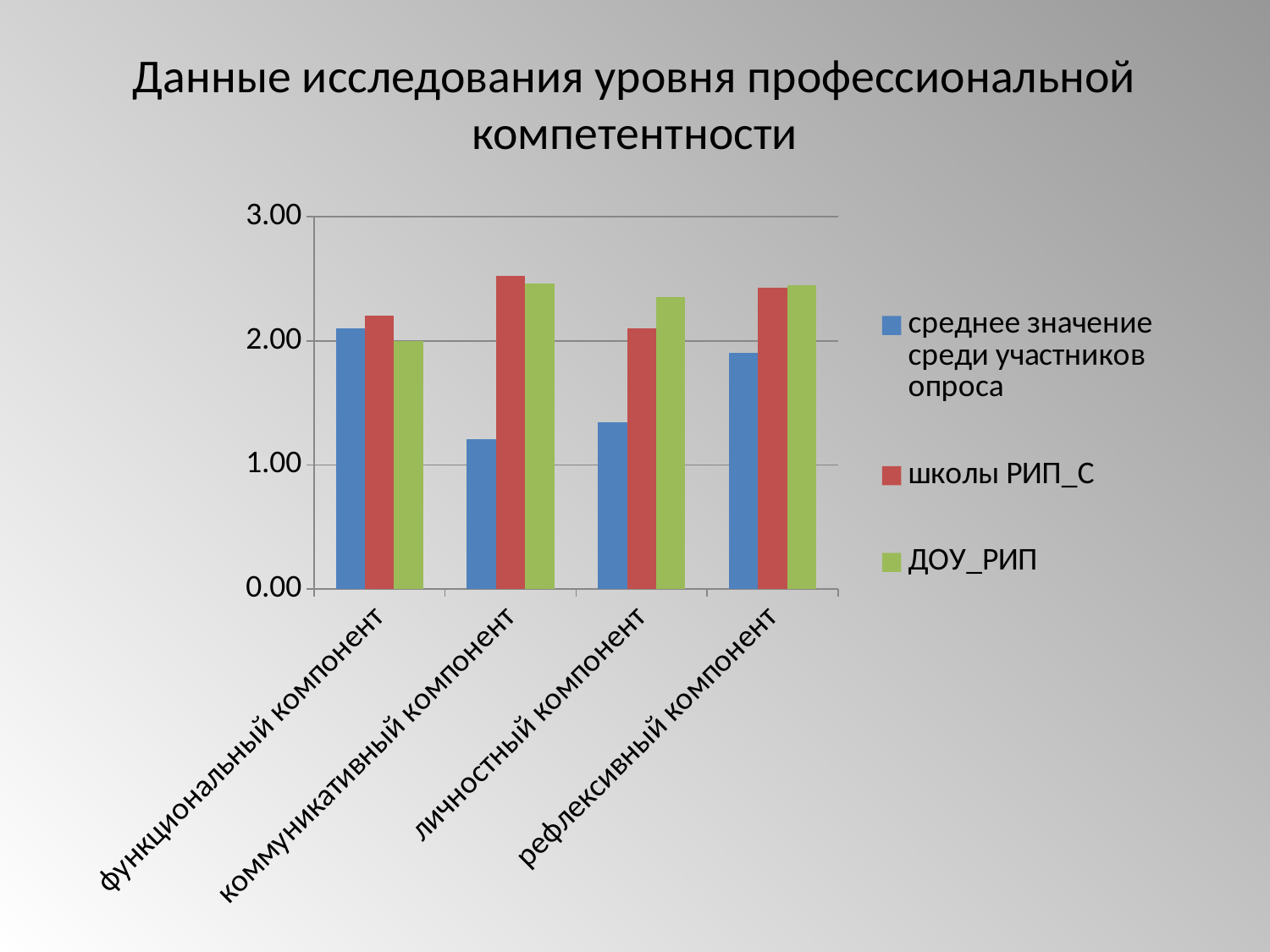
Is the value for 'школы РИП_С' in 'коммуникативный компонент' greater or less than 2.00? greater What is the title of the chart on the slide? Данные исследования уровня профессиональной компетентности Is the value for 'ДОУ_РИП' in 'личностный компонент' greater or less than 2.00? greater In 'личностный компонент', which is larger: 'среднее значение среди участников опроса' or 'ДОУ_РИП'? ДОУ_РИП Is the value for 'среднее значение среди участников опроса' in 'коммуникативный компонент' greater or less than 2.00? less In which category is the 'среднее значение среди участников опроса' series lowest? коммуникативный компонент What kind of chart is shown on the slide? bar chart How many categories are shown on the x axis of the chart? 4 In which category is the 'среднее значение среди участников опроса' series highest? функциональный компонент What colour are the bars for the 'ДОУ_РИП' series? green How many series does the legend list? 3